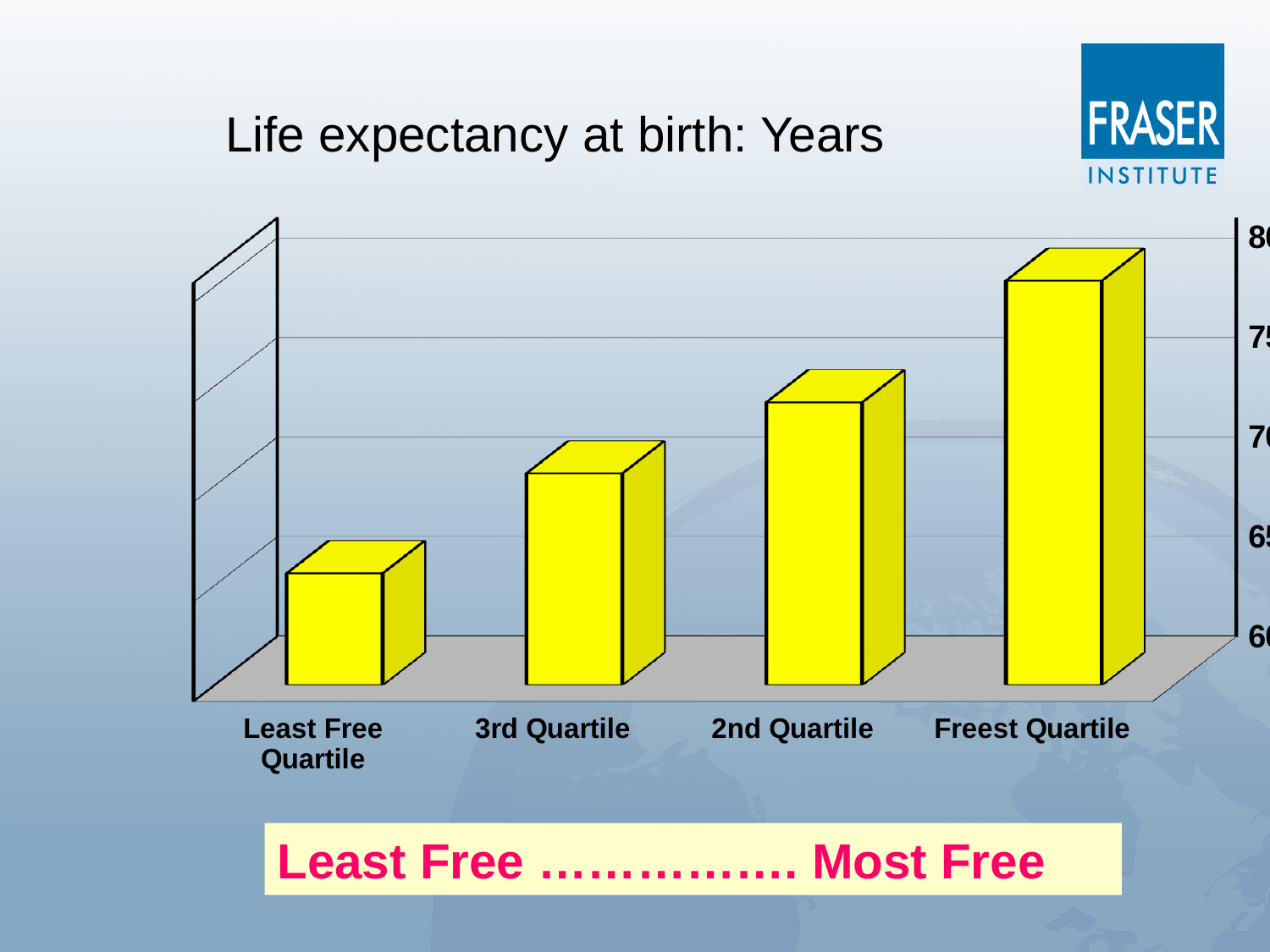
Which category has the highest life expectancy at birth? Freest Quartile How many categories (bars) are plotted in the chart? 4 What is the title of the chart? Life expectancy at birth: Years Is the value for the Freest Quartile greater or less than 75? greater What colour are the bars in the chart? yellow What kind of chart is shown on the slide? bar chart Is the value for the 2nd Quartile greater or less than 70? greater Do the values rise or fall moving from the Least Free Quartile to the Freest Quartile along the x axis? rise Which category has the lowest life expectancy at birth? Least Free Quartile Which is larger, the value for the 2nd Quartile or the value for the 3rd Quartile? 2nd Quartile